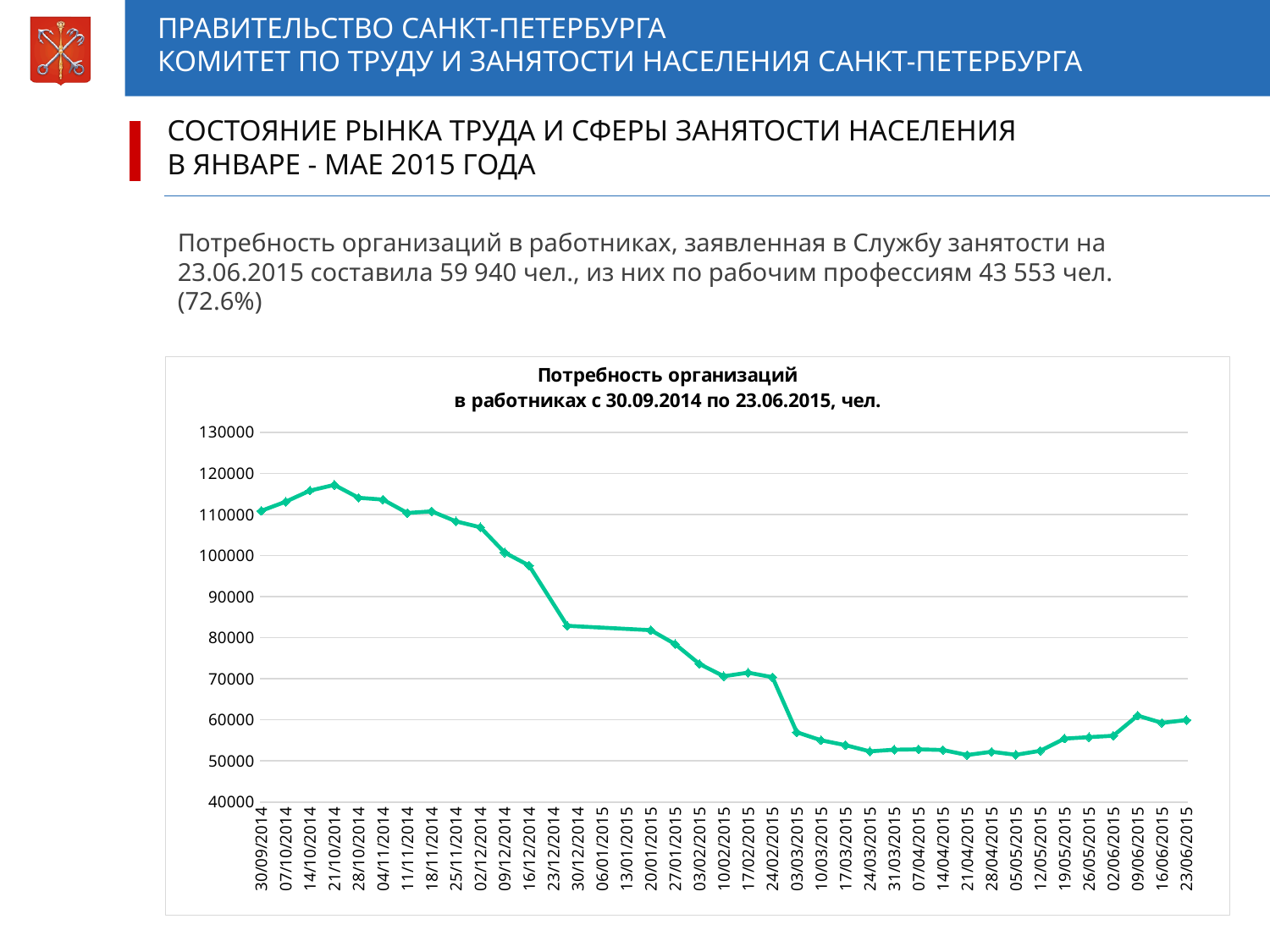
Is the value for 14/10/2014 greater or less than 110000? greater On which date does the chart reach its highest value? 21/10/2014 Overall, do the values rise or fall from 30/09/2014 to 23/06/2015? fall Is the value for 03/02/2015 greater or less than 80000? less How many dates are plotted along the x axis of the chart? 39 Is the value for 23/12/2014 greater or less than 90000? less Which date has the larger value, 21/10/2014 or 23/06/2015? 21/10/2014 Which date has the larger value, 30/09/2014 or 23/12/2014? 30/09/2014 What kind of chart is shown on the slide? line chart What is the title of the chart? Потребность организаций в работниках с 30.09.2014 по 23.06.2015, чел.